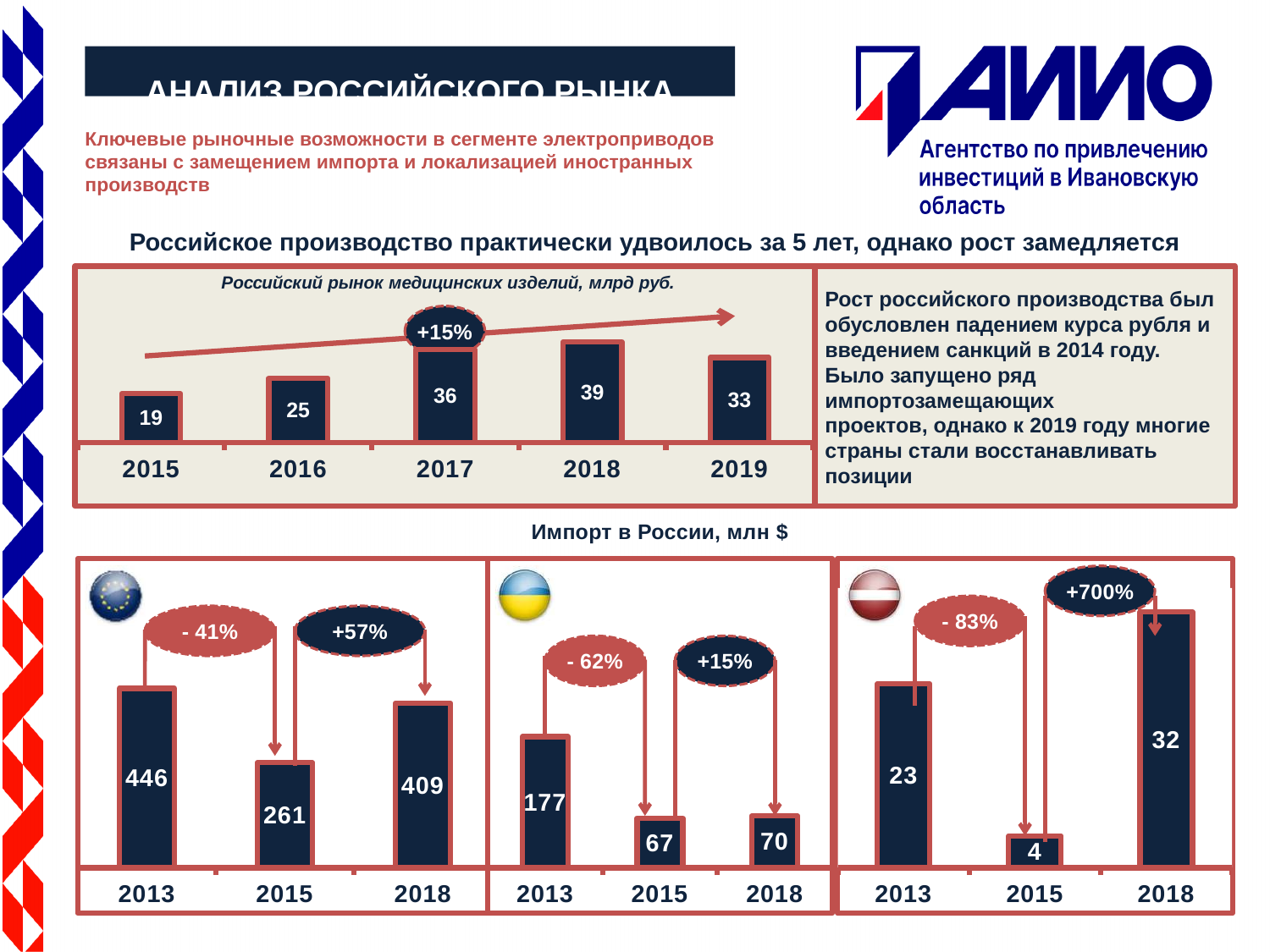
In the bottom-left import chart (EU flag), what is the value for 2015? 261 In the bottom-left import chart (EU flag), which year has the highest value? 2013 What type of chart is the chart titled 'Российский рынок медицинских изделий, млрд руб.'? bar chart In the chart titled 'Российский рынок медицинских изделий, млрд руб.', which year has the lowest value? 2015 In the bottom-middle import chart (Ukraine flag), what is the difference between the 2013 and 2015 values? 110 In the chart titled 'Российский рынок медицинских изделий, млрд руб.', what is the difference between the 2018 and 2015 values? 20 In the chart titled 'Российский рынок медицинских изделий, млрд руб.', what is the value for 2017? 36 In the bottom-middle import chart (Ukraine flag), which is larger, the value for 2015 or the value for 2018? 2018 In the chart titled 'Российский рынок медицинских изделий, млрд руб.', which year has the highest value? 2018 In the chart titled 'Российский рынок медицинских изделий, млрд руб.', how many years are plotted? 5 In the bottom-right import chart (Latvia flag), what is the value for 2018? 32 In the bottom-right import chart (Latvia flag), which year has the lowest value? 2015